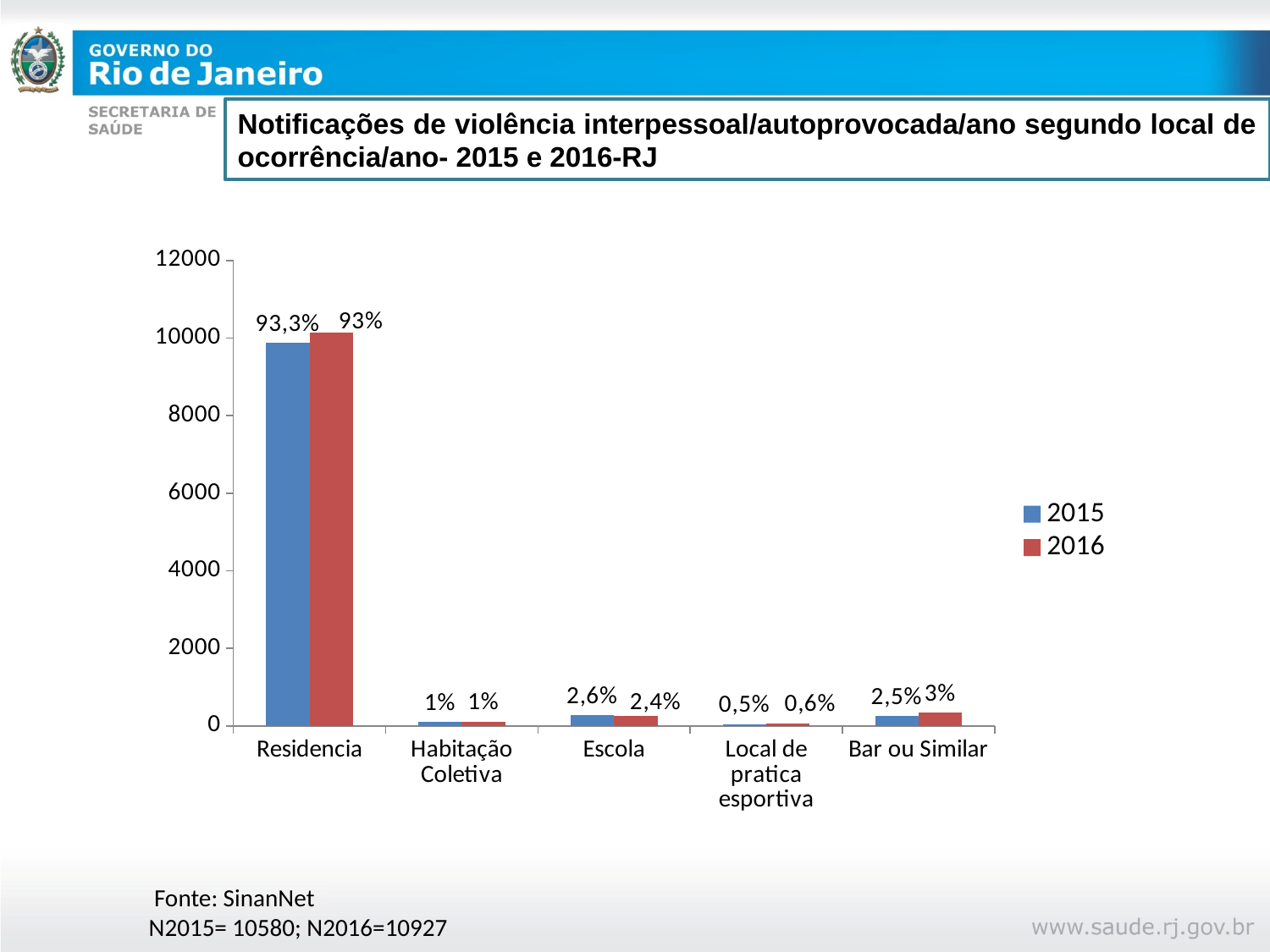
What percentage label is shown for Bar ou Similar in 2016? 3% What percentage label is shown for Escola in 2015? 2,6% What percentage label is shown for Residencia in 2015? 93,3% How many series does the legend list? 2 What percentage label is shown for Residencia in 2016? 93% What is the difference between the 2015 and 2016 percentage labels for Escola? 0,2% How many location categories are shown on the x axis? 5 Is the value for Residencia in 2015 greater or less than 8000? greater What kind of chart is shown on the slide? Bar chart For Bar ou Similar, which year has the larger value, 2015 or 2016? 2016 Which location has the highest number of notifications in both years? Residencia Which location has the lowest number of notifications in 2015? Local de pratica esportiva